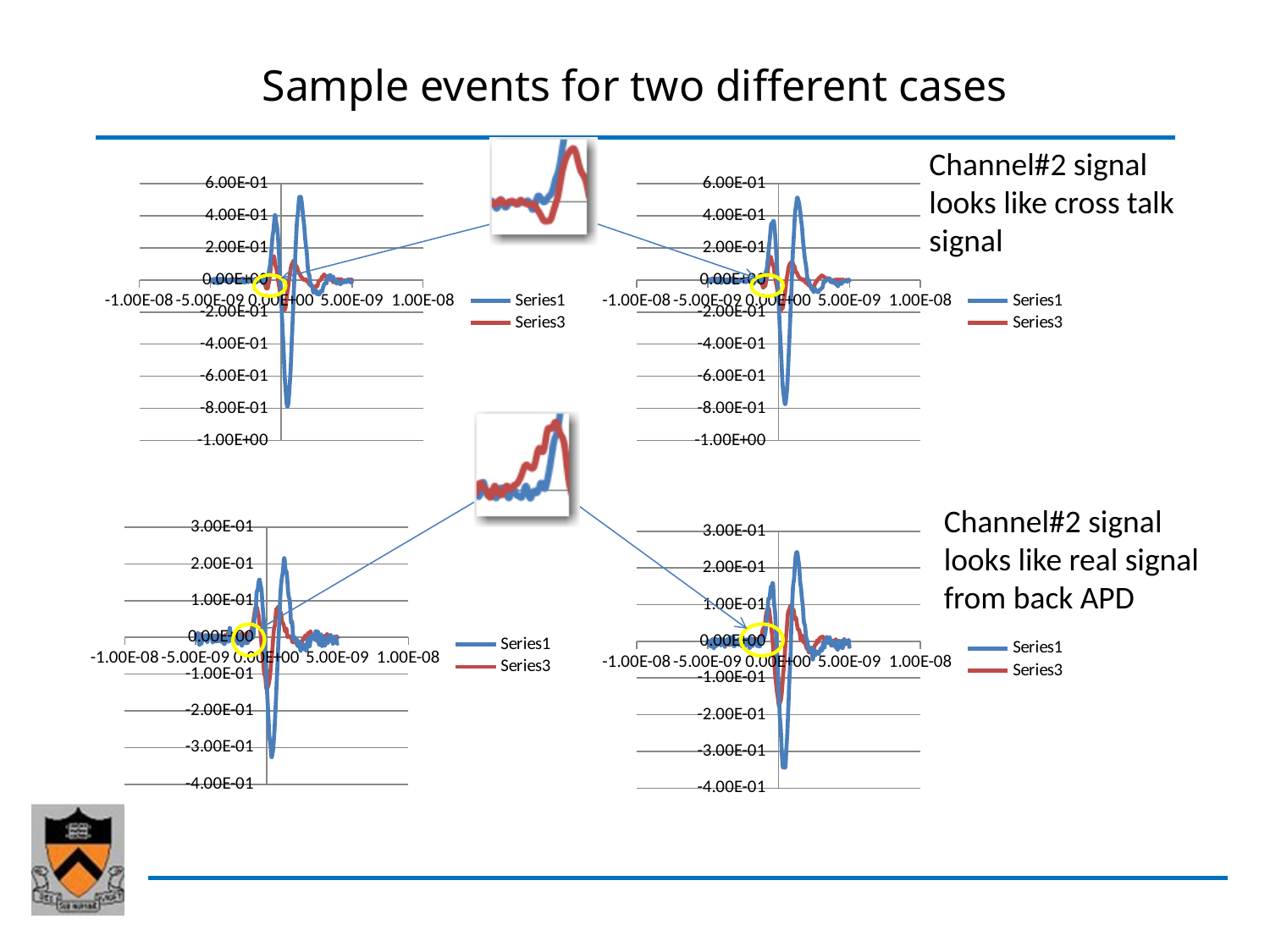
How many charts are shown on the slide? 4 In the bottom-right chart, which series reaches the higher peak, Series1 or Series3? Series1 In the top-left chart, is the highest peak of Series1 greater or less than 4.00E-01? greater In the bottom-right chart, is the lowest value reached by Series1 greater or less than -2.00E-01? less In the bottom-right chart, what are the names of the series listed in the legend? Series1 and Series3 In the top-left chart, which series reaches the higher peak, Series1 or Series3? Series1 In the top-left chart, what is the highest tick value shown on the y axis? 6.00E-01 In the top-right chart, is the highest peak of Series3 greater or less than 4.00E-01? less In the top-left chart, how many series does the legend list? 2 What kind of chart is the top-left chart? line chart